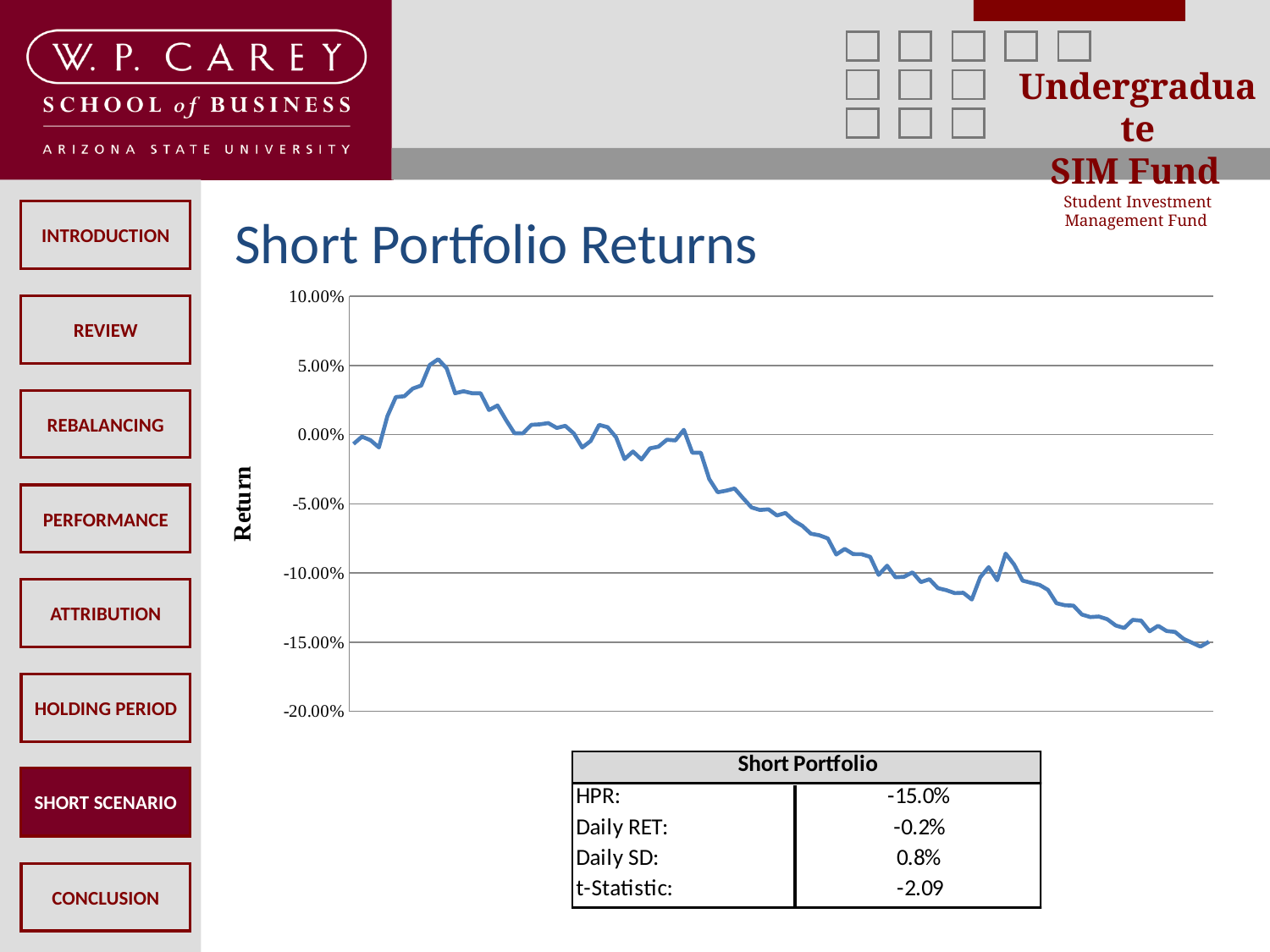
What is the title of the chart? Short Portfolio Returns Is the highest point of the line greater or less than 10.00%? less What is the lowest value shown on the vertical axis of the chart? -20.00% Is the value at the right end of the line greater or less than -5.00%? less Overall, do the values in the chart rise or fall from left to right? fall What is the label on the vertical axis of the chart? Return Is the lowest point of the line greater or less than -20.00%? greater What kind of chart is shown on the slide? line chart Which is larger, the value at the left end of the line or the value at the right end of the line? the left end